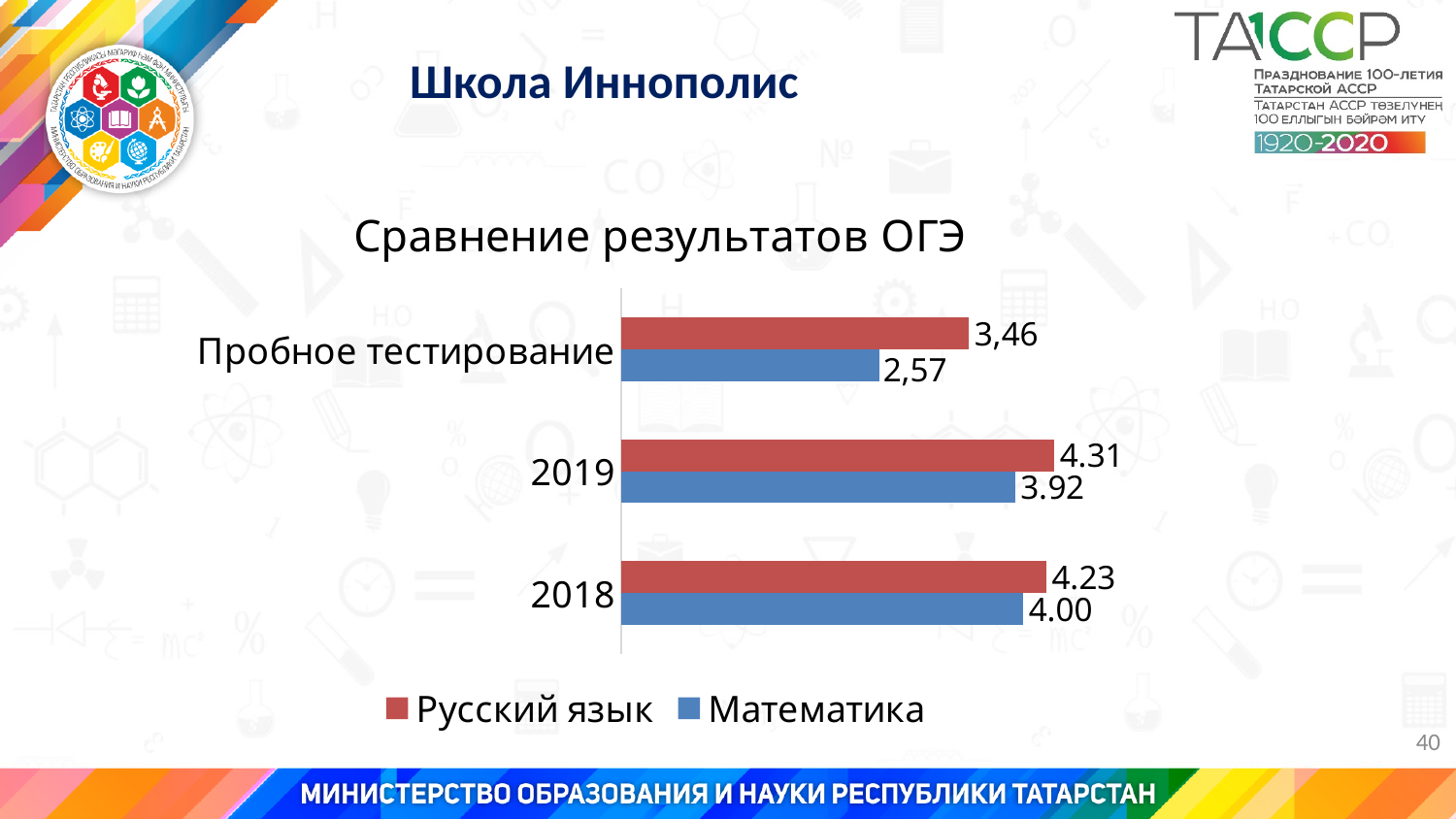
What kind of chart is shown on the slide? Bar chart How many series does the legend list? 2 What is the difference between Русский язык and Математика in 2019? 0.39 Which category has the lowest value for Математика? Пробное тестирование What is the title of the chart? Сравнение результатов ОГЭ Which is larger in 2018, Русский язык or Математика? Русский язык What is the value for Математика in Пробное тестирование? 2,57 What is the value for Русский язык in 2019? 4.31 How many categories are shown on the chart? 3 Which colour represents Математика in the chart? Blue What is the value for Математика in 2018? 4.00 Which category has the highest value for Русский язык? 2019